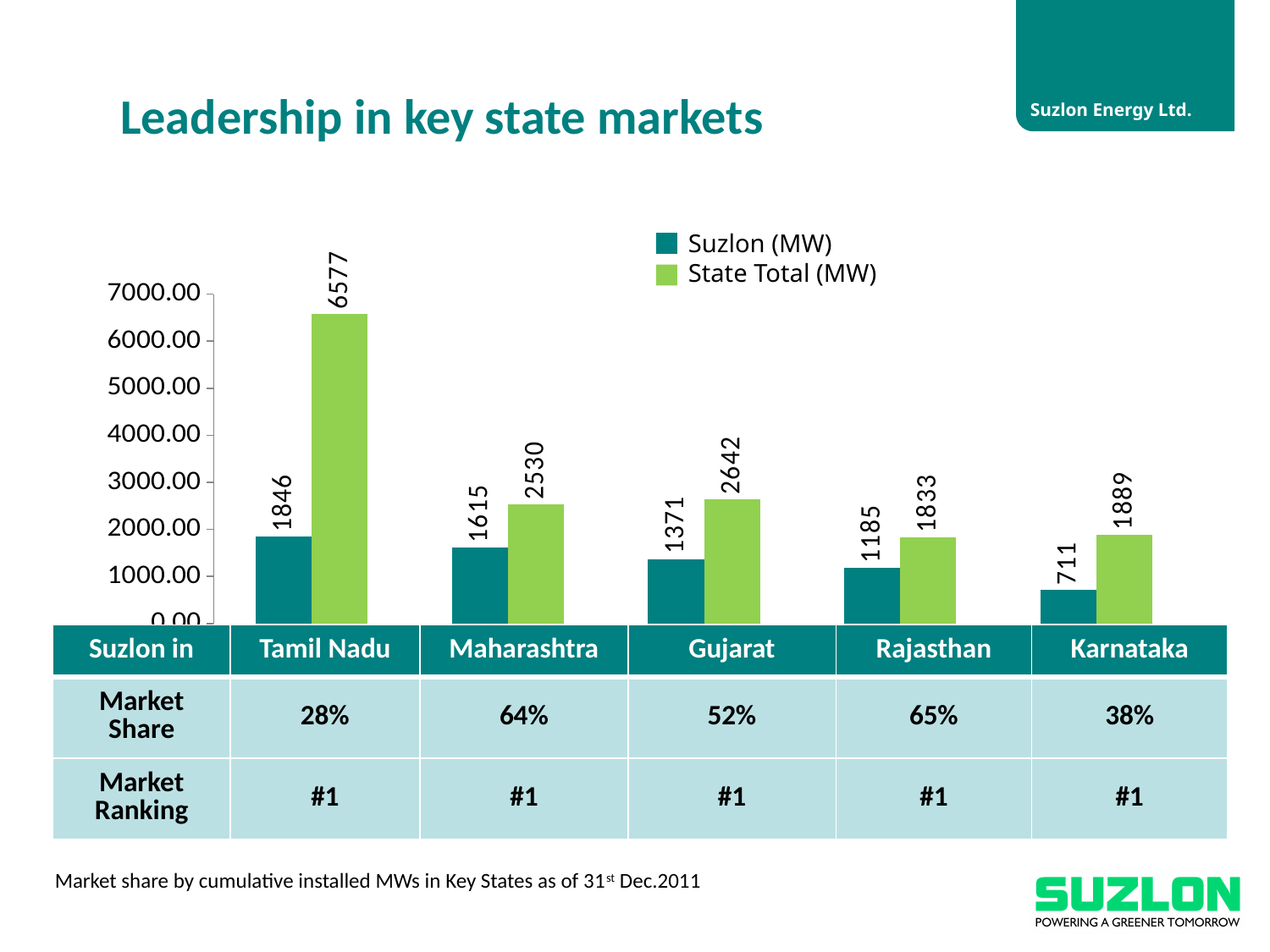
How many series does the chart legend list? 2 What is the Suzlon (MW) value for Karnataka? 711 What is the Suzlon (MW) value for Tamil Nadu? 1846 How many states are shown on the x axis of the chart? 5 Does the Suzlon (MW) series rise or fall from Tamil Nadu to Karnataka along the x axis? Fall Which state has the lowest Suzlon (MW) value? Karnataka What is the difference between the State Total (MW) and Suzlon (MW) values for Maharashtra? 915 What kind of chart is shown on the slide? Bar chart Which is larger, the State Total (MW) for Rajasthan or for Karnataka? Karnataka Which state has the highest State Total (MW)? Tamil Nadu Is the State Total (MW) for Tamil Nadu greater or less than 6000.00? greater What is the State Total (MW) value for Gujarat? 2642